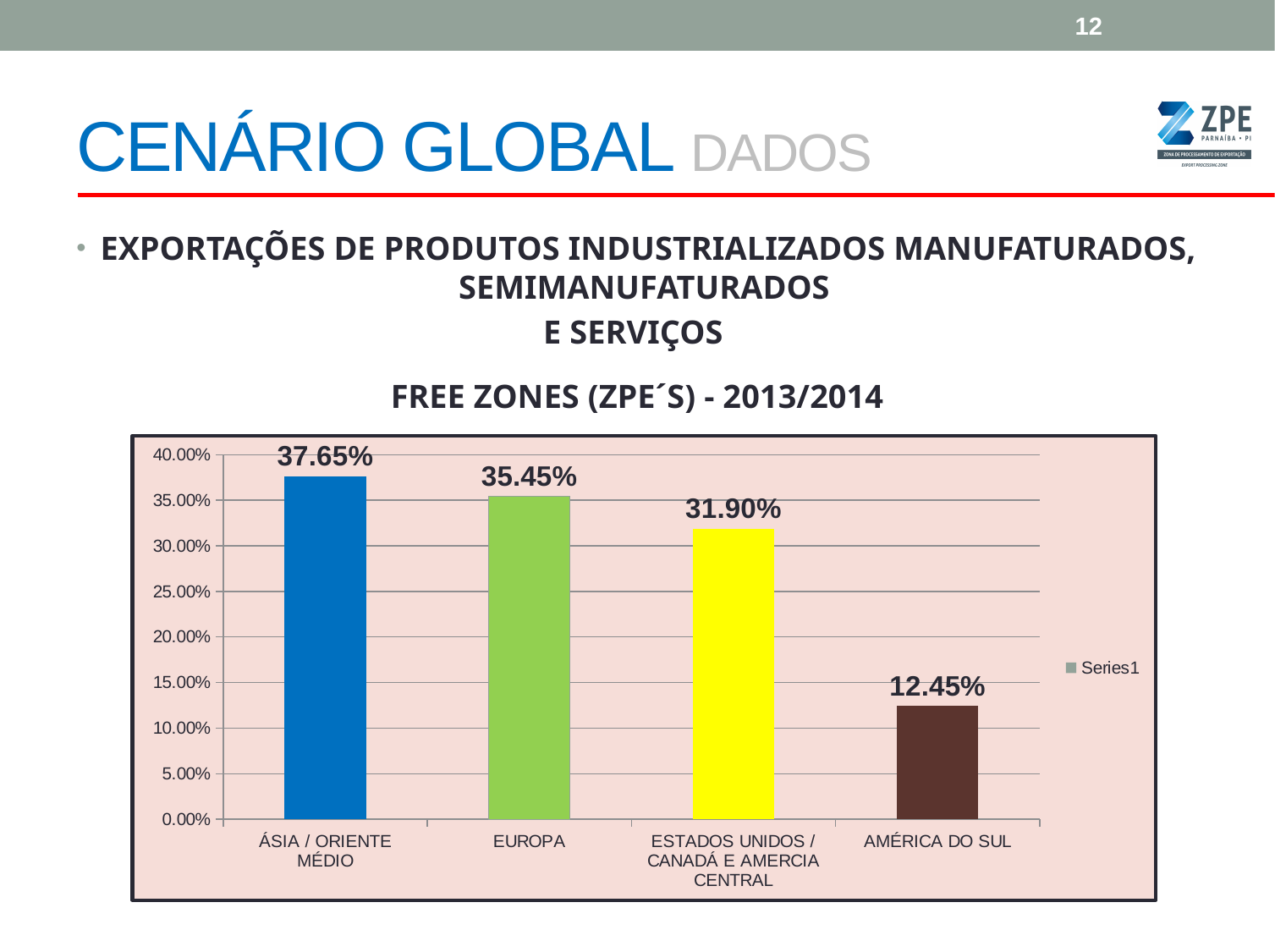
What is the value for AMÉRICA DO SUL? 12.45% What kind of chart is shown on the slide? bar chart Which category has the highest value? ÁSIA / ORIENTE MÉDIO Which is larger, the value for EUROPA or the value for ESTADOS UNIDOS / CANADÁ E AMERCIA CENTRAL? EUROPA Which category has the lowest value? AMÉRICA DO SUL How many series does the legend list? 1 How many categories are shown in the chart? 4 Is the value for AMÉRICA DO SUL greater or less than 15.00%? less What is the difference between the values for EUROPA and ESTADOS UNIDOS / CANADÁ E AMERCIA CENTRAL? 3.55% What is the difference between the values for ÁSIA / ORIENTE MÉDIO and AMÉRICA DO SUL? 25.20% What is the value for ESTADOS UNIDOS / CANADÁ E AMERCIA CENTRAL? 31.90% What is the value for EUROPA? 35.45%